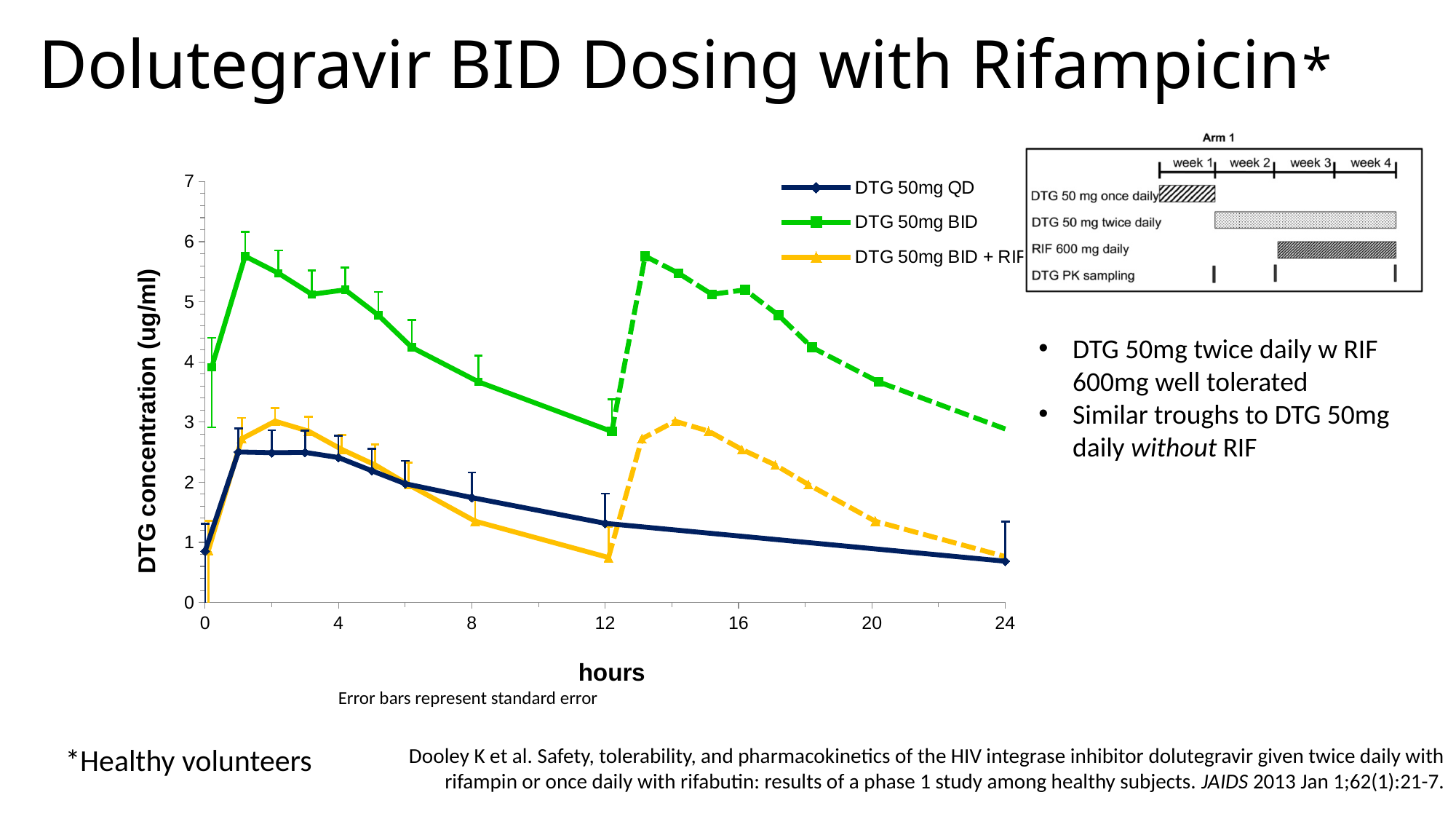
What kind of chart is shown on the slide? line chart Is the peak DTG 50mg BID concentration greater or less than 5? greater At 4 hours, which series has the higher DTG concentration: DTG 50mg BID or DTG 50mg QD? DTG 50mg BID Is the DTG 50mg BID concentration at 8 hours greater or less than 3? greater Is the DTG 50mg BID + RIF concentration at 12 hours greater or less than 1? less Does the DTG 50mg QD concentration rise or fall between 4 and 24 hours? fall Which series has the lowest peak DTG concentration on the chart? DTG 50mg QD How many series does the chart legend list? 3 Which series reaches the highest DTG concentration on the chart? DTG 50mg BID According to the note under the chart, what do the error bars represent? standard error What are the three series listed in the chart legend? DTG 50mg QD, DTG 50mg BID, DTG 50mg BID + RIF